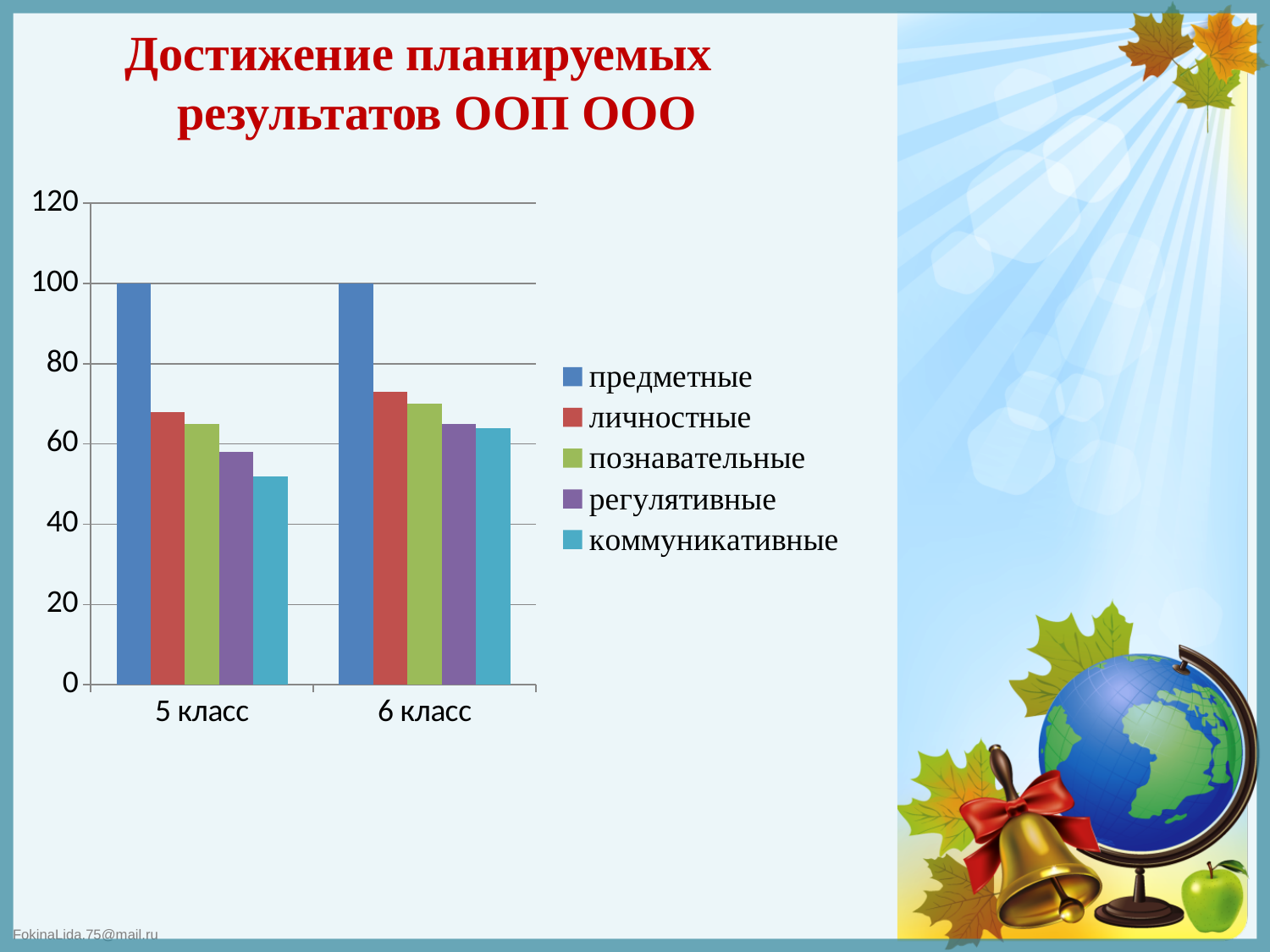
Is the value for коммуникативные in 5 класс greater or less than 60? less Is the value for регулятивные in 6 класс greater or less than 60? greater Which series has the highest value in 5 класс? предметные What kind of chart is shown on the slide? bar chart Does the value for коммуникативные rise or fall from 5 класс to 6 класс? rise What is the value for предметные in 6 класс? 100 Is the value for личностные in 6 класс greater or less than 80? less Which series has the lowest value in 5 класс? коммуникативные Which is larger, the value for коммуникативные in 5 класс or in 6 класс? 6 класс How many series does the legend list? 5 What is the value for предметные in 5 класс? 100 How many categories are shown on the x axis? 2